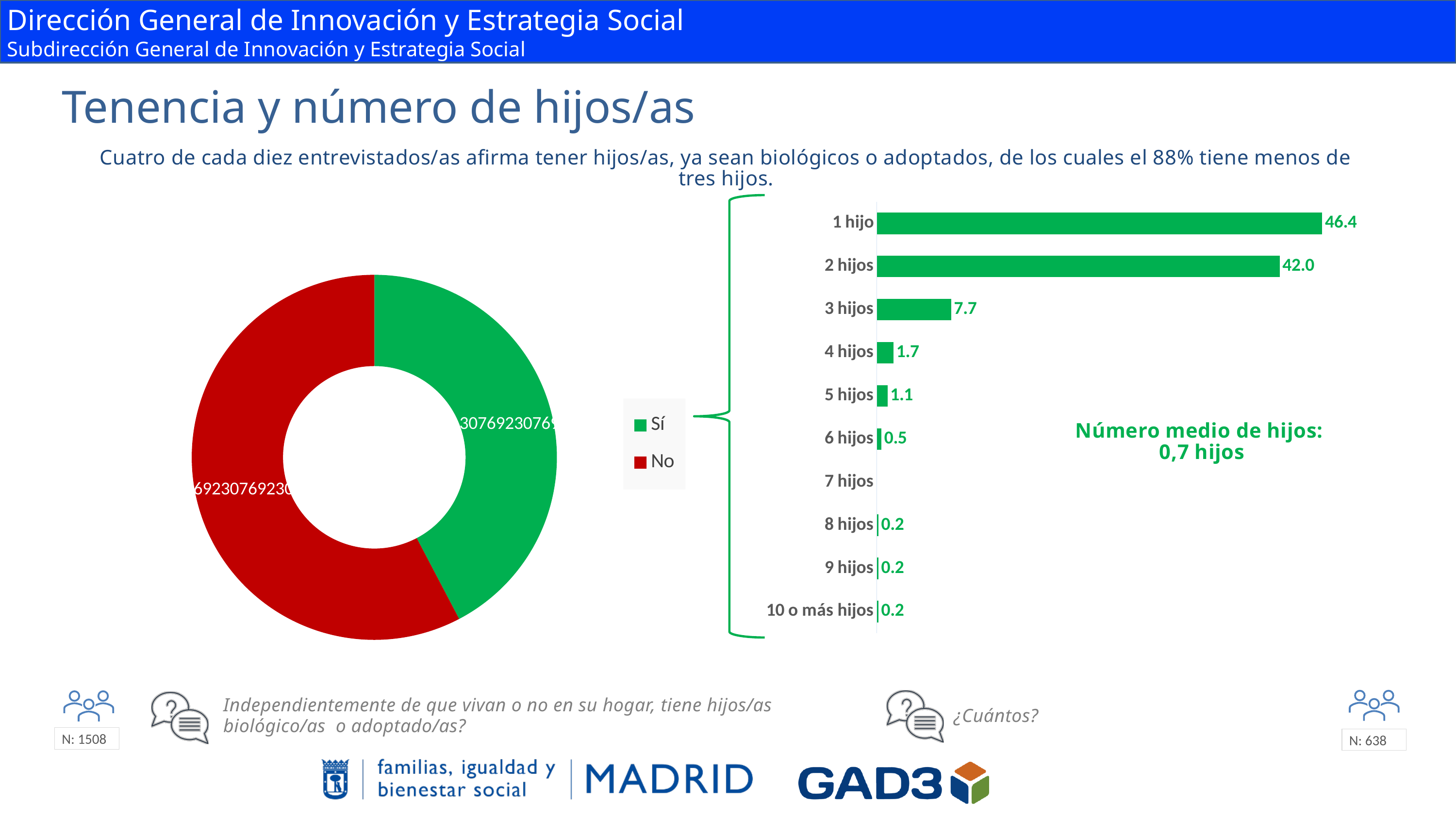
What kind of chart is the chart on the right of the slide? Bar chart In the bar chart on the right, what is the value for 1 hijo? 46.4 How many entries does the legend of the donut chart on the left list? 2 In the bar chart on the right, what is the value for 5 hijos? 1.1 In the bar chart on the right, what is the difference between the values for 1 hijo and 2 hijos? 4.4 In the bar chart on the right, which is larger, the value for 4 hijos or the value for 6 hijos? 4 hijos How many categories are shown in the bar chart on the right? 10 In the bar chart on the right, what is the value for 2 hijos? 42.0 In the donut chart on the left, which slice is larger, Sí or No? No In the bar chart on the right, which category has the highest value? 1 hijo In the bar chart on the right, what is the value for 3 hijos? 7.7 In the bar chart on the right, what is the difference between the values for 3 hijos and 4 hijos? 6.0